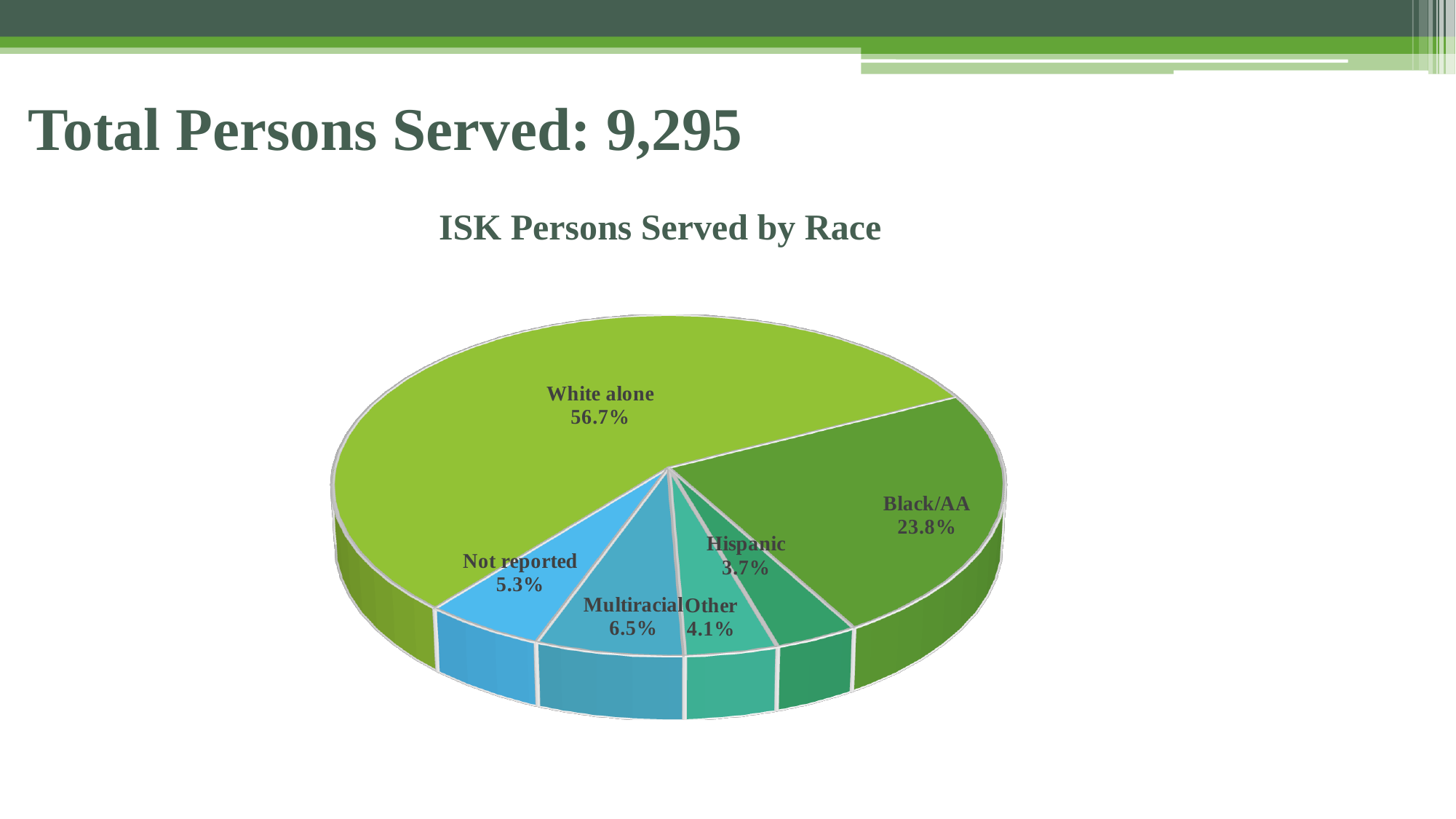
What percentage of persons served are Hispanic? 3.7% What percentage of persons served are Black/AA? 23.8% What percentage of persons served are White alone? 56.7% Which race category has the largest share of the pie? White alone What is the difference in percentage points between White alone and Black/AA? 32.9 What type of chart is shown on the slide? Pie chart What is the title of the chart? ISK Persons Served by Race What percentage of persons served are in the Not reported category? 5.3% Which is larger, the share for Multiracial or the share for Other? Multiracial How many categories are shown in the pie chart? 6 What percentage of persons served are Multiracial? 6.5% Which race category has the smallest share of the pie? Hispanic